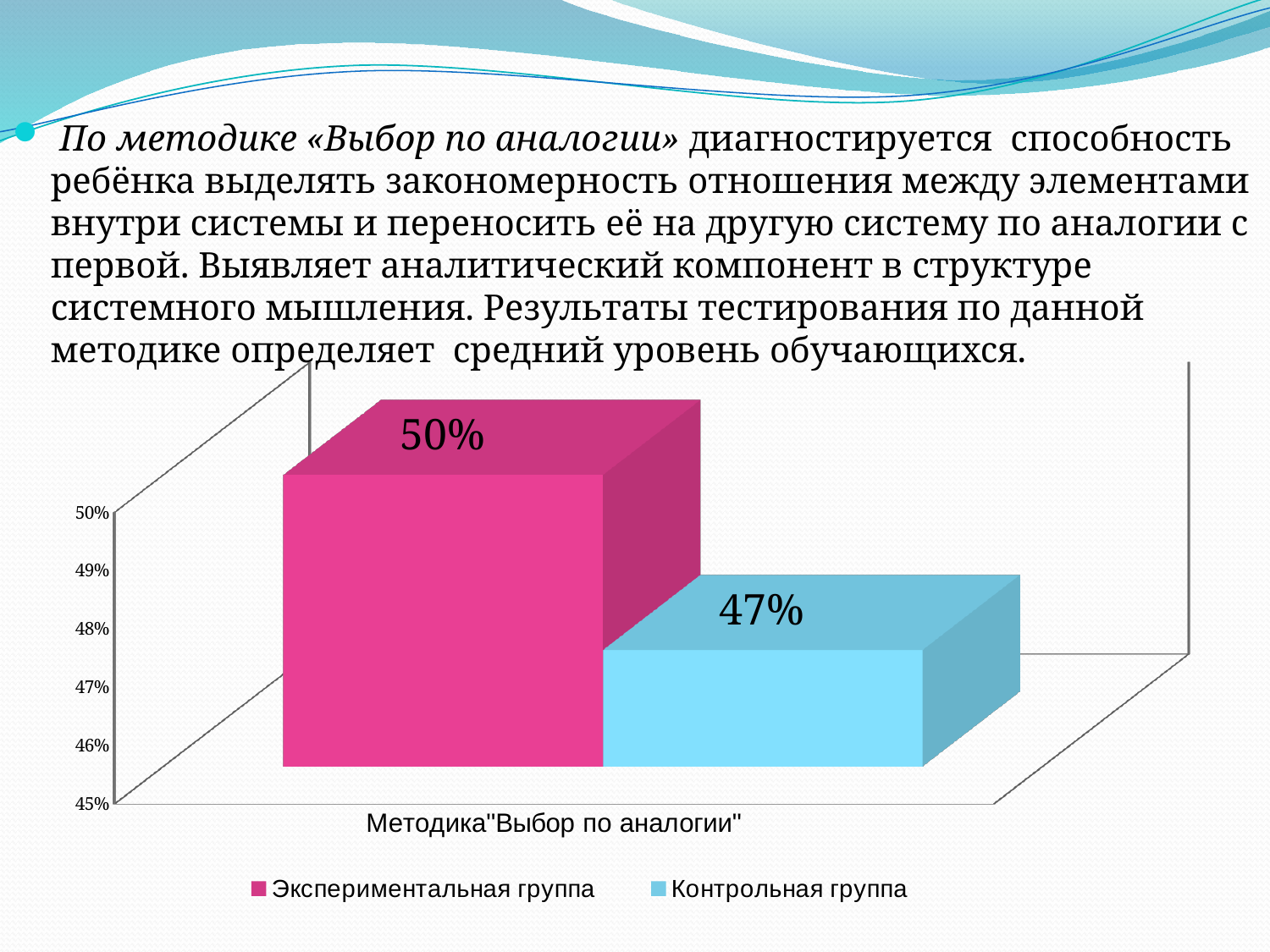
What kind of chart is shown? bar chart How many series does the legend list? 2 Which is larger, the value for Экспериментальная группа or for Контрольная группа? Экспериментальная группа What colour is the bar for Контрольная группа? light blue Which series has the highest value? Экспериментальная группа What is the value for Контрольная группа? 47% How many categories are shown on the x axis? 1 What is the difference between the values for Экспериментальная группа and Контрольная группа? 3% What is the value for Экспериментальная группа? 50% What is the category label on the x axis? Методика"Выбор по аналогии" Which series has the lowest value? Контрольная группа Is the value for Контрольная группа greater or less than 48%? less